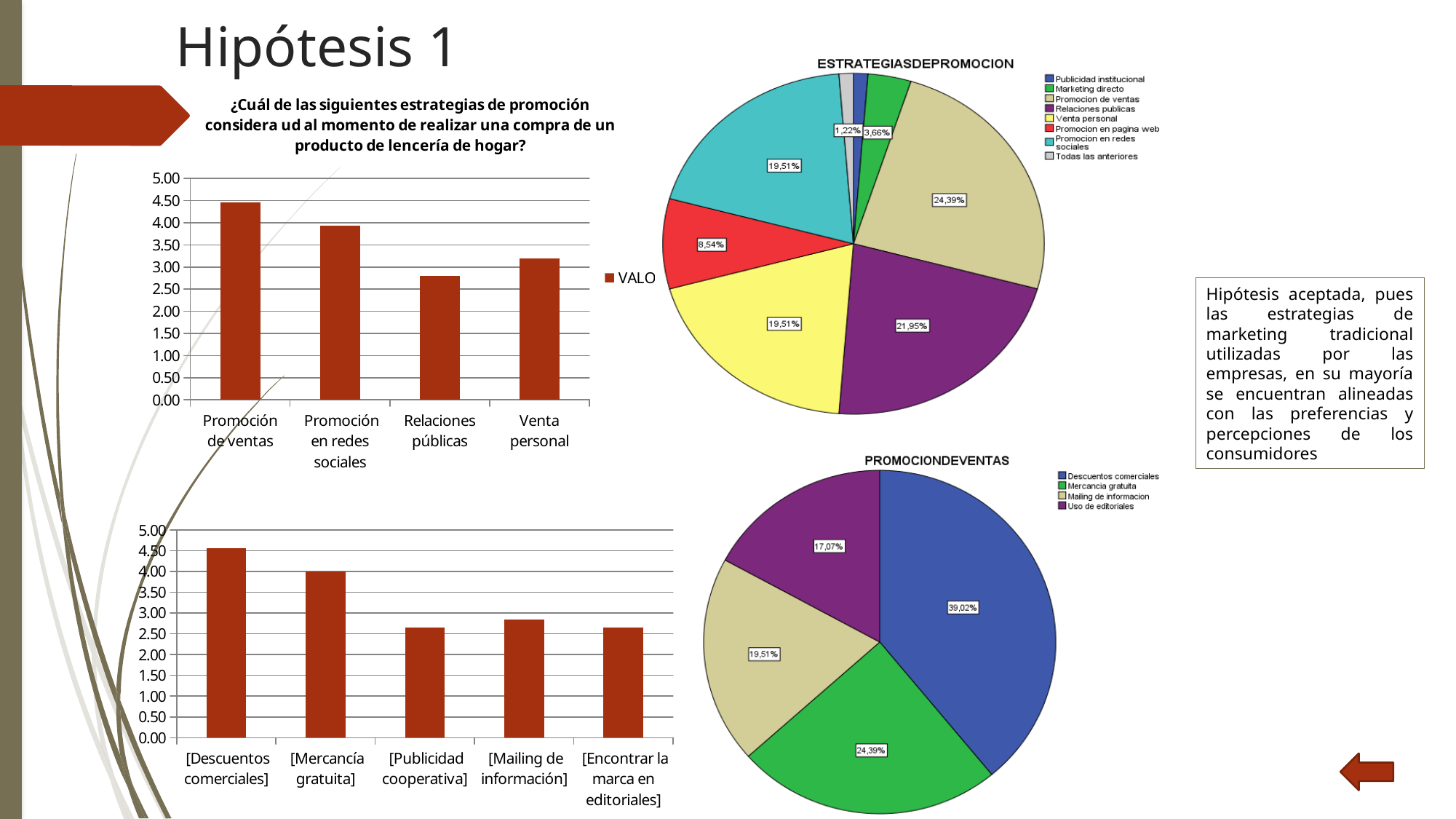
In the PROMOCIONDEVENTAS pie chart, what share does Uso de editoriales have? 17,07% In the ESTRATEGIASDEPROMOCION pie chart, what share does Promocion de ventas have? 24,39% In the ESTRATEGIASDEPROMOCION pie chart, what share does Promocion en pagina web have? 8,54% In the bottom-left bar chart, is the value for Descuentos comerciales greater or less than 4.00? greater In the top-left bar chart, is the value for Relaciones públicas greater or less than 3.00? less In the PROMOCIONDEVENTAS pie chart, what is the difference between the shares of Mercancia gratuita and Mailing de informacion? 4,88% In the ESTRATEGIASDEPROMOCION pie chart, which category has the largest slice? Promocion de ventas How many entries does the legend of the ESTRATEGIASDEPROMOCION pie chart list? 8 In the PROMOCIONDEVENTAS pie chart, which category has the smallest slice? Uso de editoriales In the top-left bar chart, which category has the highest bar? Promoción de ventas